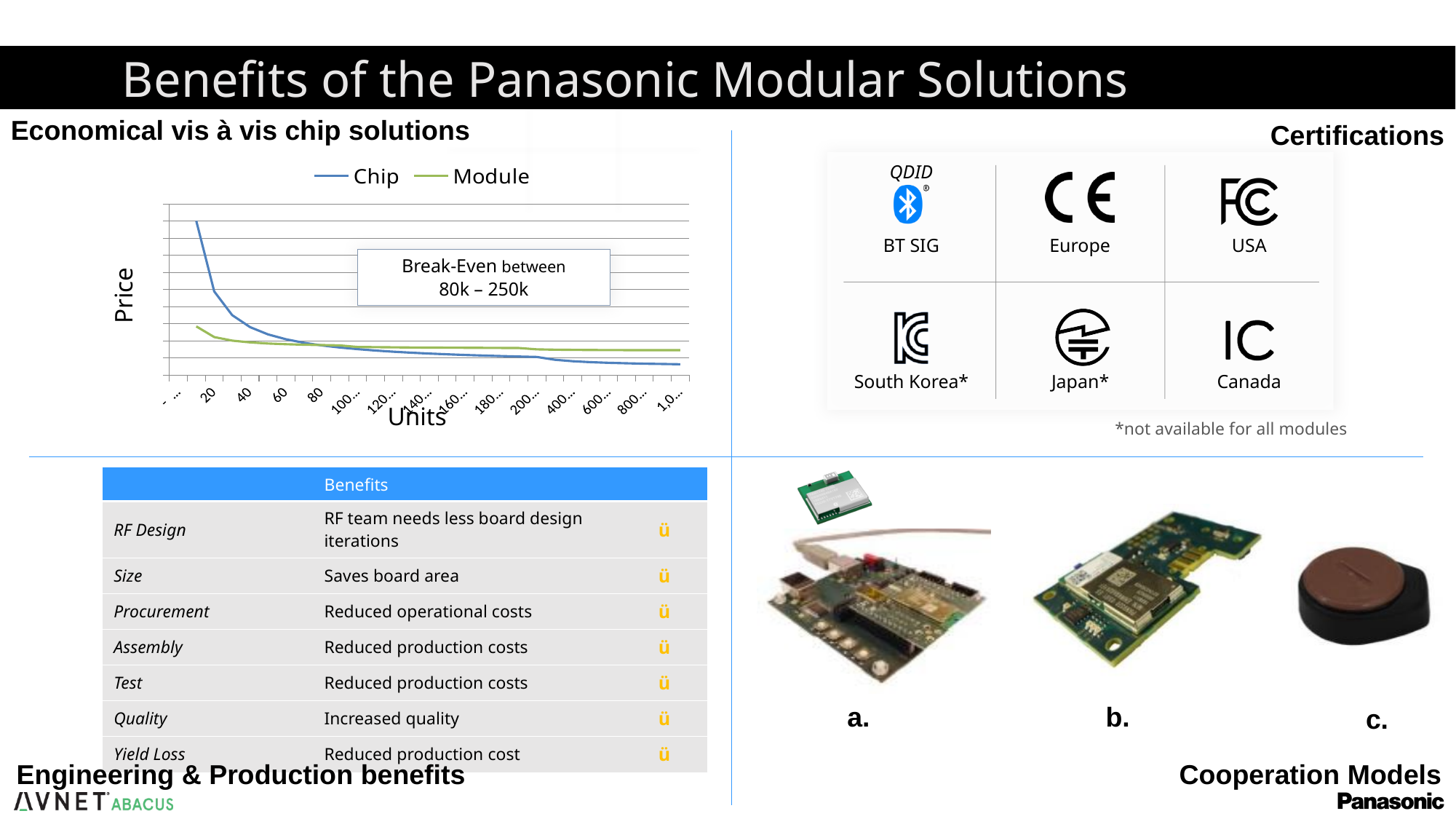
What are the two series named in the legend of the price chart? Chip and Module What kind of chart is shown under 'Economical vis à vis chip solutions'? line chart In the price chart, does the Chip line rise or fall as units increase? fall In the price chart, which series has the higher price at 20 units, Chip or Module? Chip What is the label of the vertical axis of the price chart? Price What is the label of the horizontal axis of the price chart? Units How many series does the legend of the price chart list? 2 In the price chart, which series has the higher price at the right end of the x axis (1,0...), Chip or Module? Module In the price chart, which series starts at the highest price at the left of the x axis? Chip